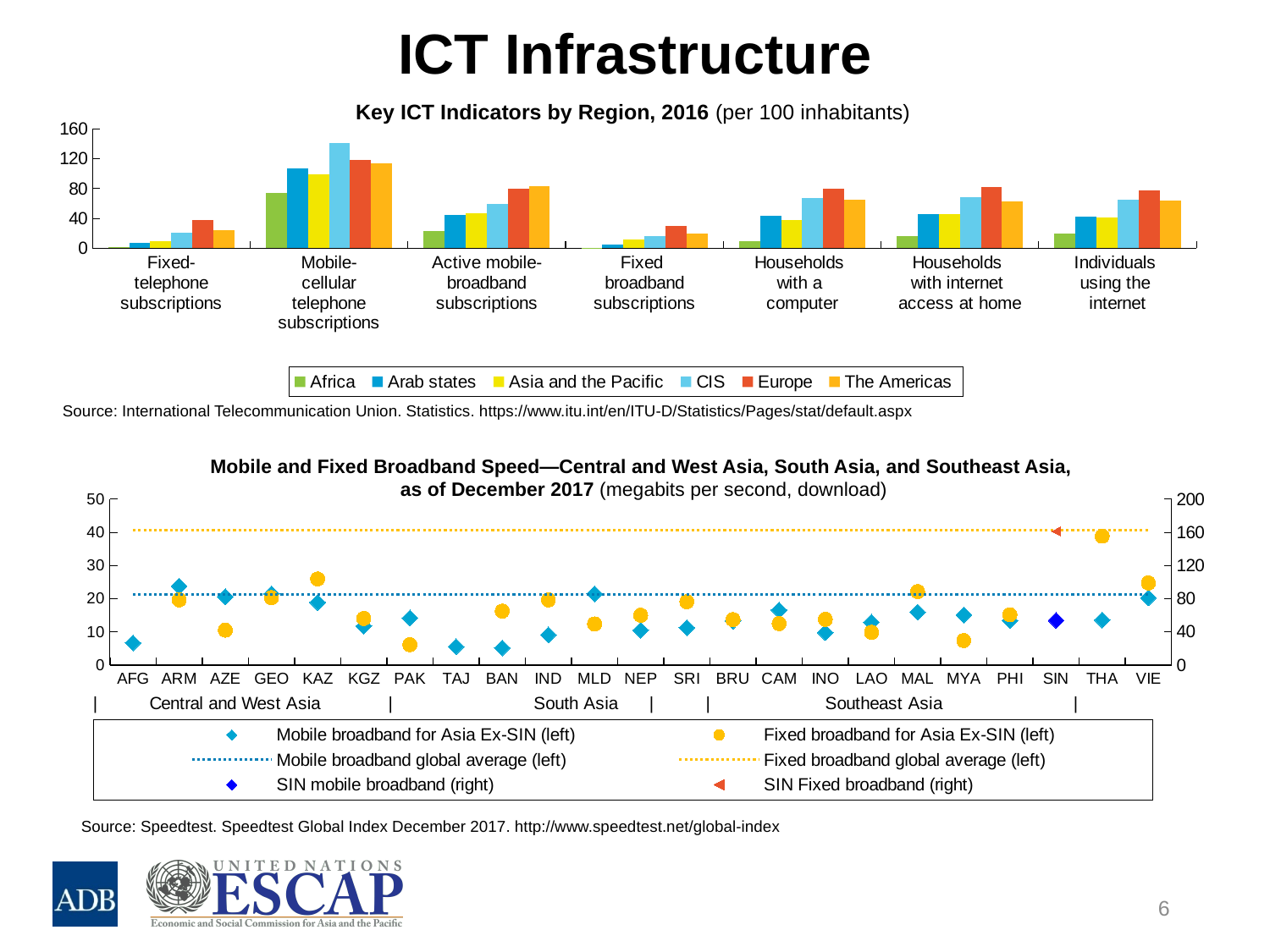
In the top chart 'Key ICT Indicators by Region, 2016', which is larger for Mobile-cellular telephone subscriptions: Africa or Arab states? Arab states In the top chart 'Key ICT Indicators by Region, 2016', how many indicator categories are shown on the x axis? 7 In the top chart 'Key ICT Indicators by Region, 2016', which region has the lowest value for Individuals using the internet? Africa In the top chart 'Key ICT Indicators by Region, 2016', which region has the highest value for Mobile-cellular telephone subscriptions? CIS In the bottom chart on broadband speed, how many entries does the legend list? 6 In the top chart 'Key ICT Indicators by Region, 2016', is the Europe value for Fixed broadband subscriptions greater or less than 40? less In the top chart 'Key ICT Indicators by Region, 2016', how many regions does the legend list? 6 In the top chart 'Key ICT Indicators by Region, 2016', which region has the highest value for Fixed broadband subscriptions? Europe In the bottom chart on broadband speed, is the fixed broadband value for THA greater or less than 30? greater In the bottom chart on broadband speed, how many countries are shown on the x axis? 23 In the top chart 'Key ICT Indicators by Region, 2016', is the CIS value for Mobile-cellular telephone subscriptions greater or less than 120? greater What type of chart is the top chart, 'Key ICT Indicators by Region, 2016'? bar chart